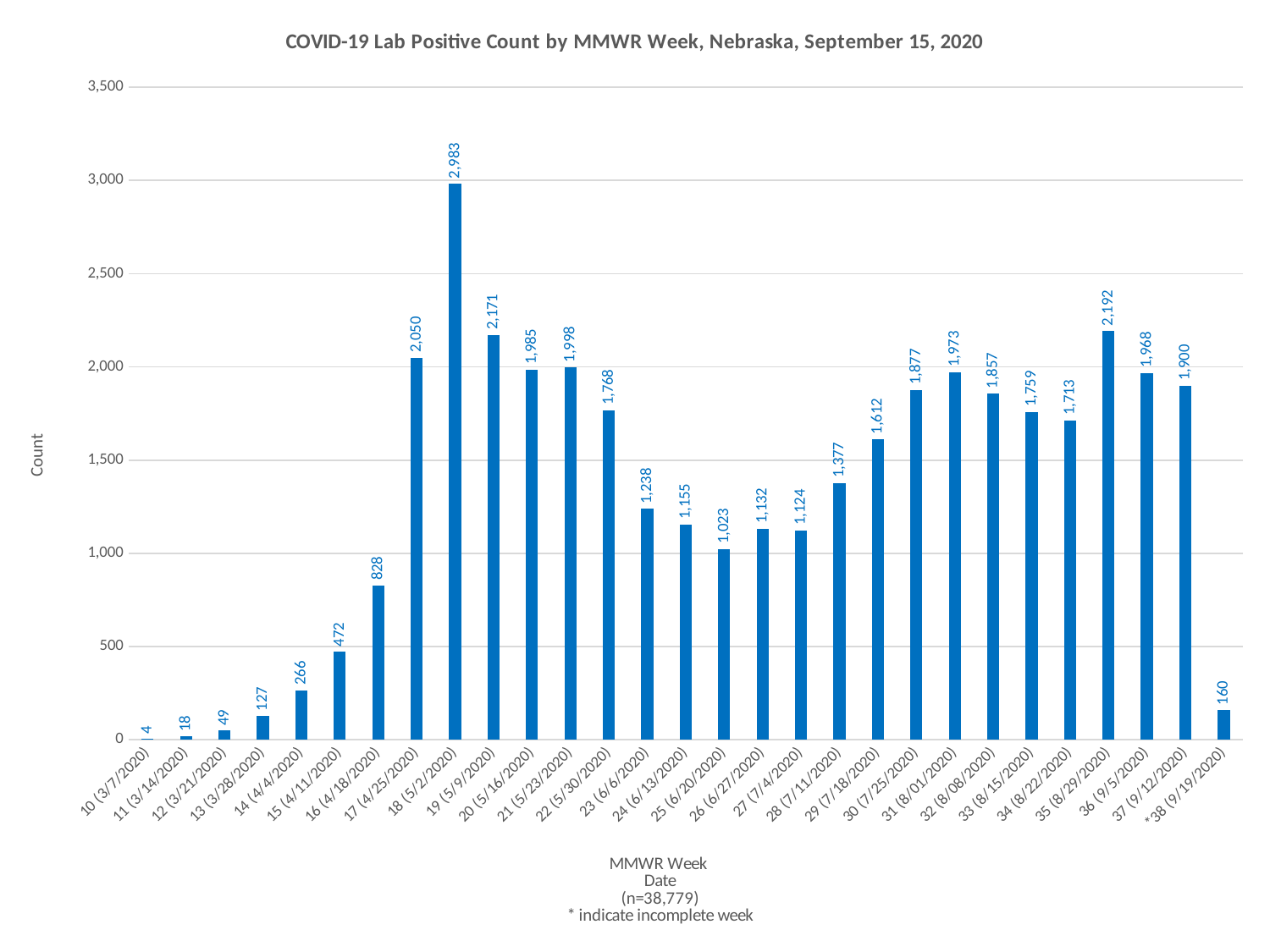
What is the lab positive count for MMWR week 35 (8/29/2020)? 2,192 What kind of chart is shown on the slide? Bar chart What is the lab positive count for MMWR week 18 (5/2/2020)? 2,983 Which MMWR week has the lowest lab positive count? 10 (3/7/2020) How many MMWR weeks are plotted on the chart? 29 Do the counts rise or fall from week 10 (3/7/2020) through week 18 (5/2/2020)? Rise Which has a larger count, week 17 (4/25/2020) or week 36 (9/5/2020)? Week 17 (4/25/2020) Which MMWR week has the highest lab positive count? 18 (5/2/2020) What is the difference between the counts for week 18 (5/2/2020) and week 19 (5/9/2020)? 812 Is the value for week 16 (4/18/2020) greater or less than 1,000? less What is the difference between the counts for week 35 (8/29/2020) and week 34 (8/22/2020)? 479